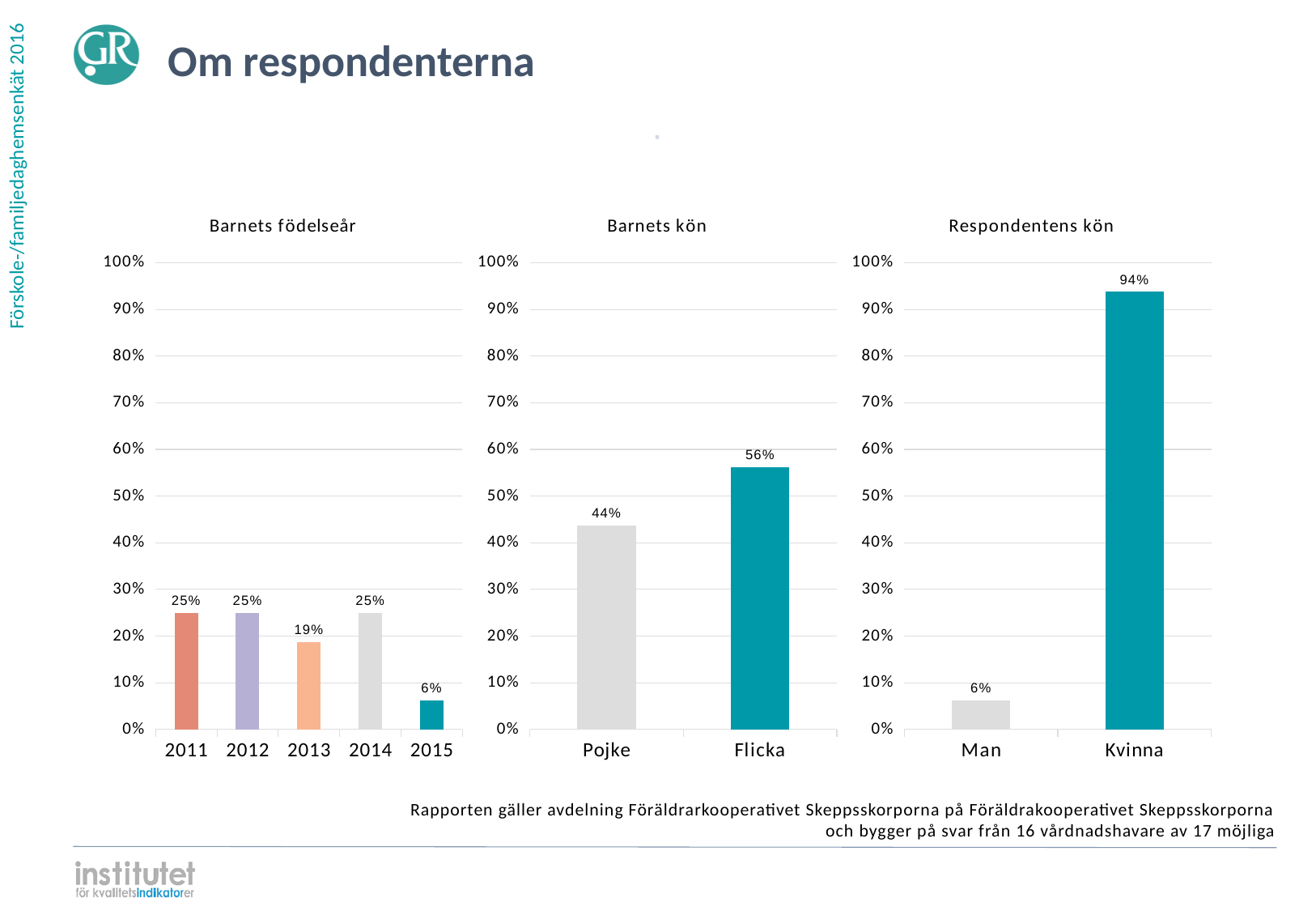
In the 'Respondentens kön' chart, what is the value for Kvinna? 94% How many charts are shown on the slide? 3 In the 'Barnets födelseår' chart, how many years are shown on the x axis? 5 In the 'Respondentens kön' chart, what is the value for Man? 6% In the 'Barnets kön' chart, what is the difference between Flicka and Pojke? 12% In the 'Barnets födelseår' chart, what is the difference between the values for 2014 and 2015? 19% In the 'Barnets kön' chart, which category is higher, Pojke or Flicka? Flicka In the 'Barnets födelseår' chart, what is the value for 2013? 19% What kind of chart is the 'Barnets kön' chart? Bar chart In the 'Respondentens kön' chart, is the value for Kvinna greater or less than 90%? greater In the 'Barnets födelseår' chart, which year has the lowest value? 2015 In the 'Barnets kön' chart, what is the value for Pojke? 44%